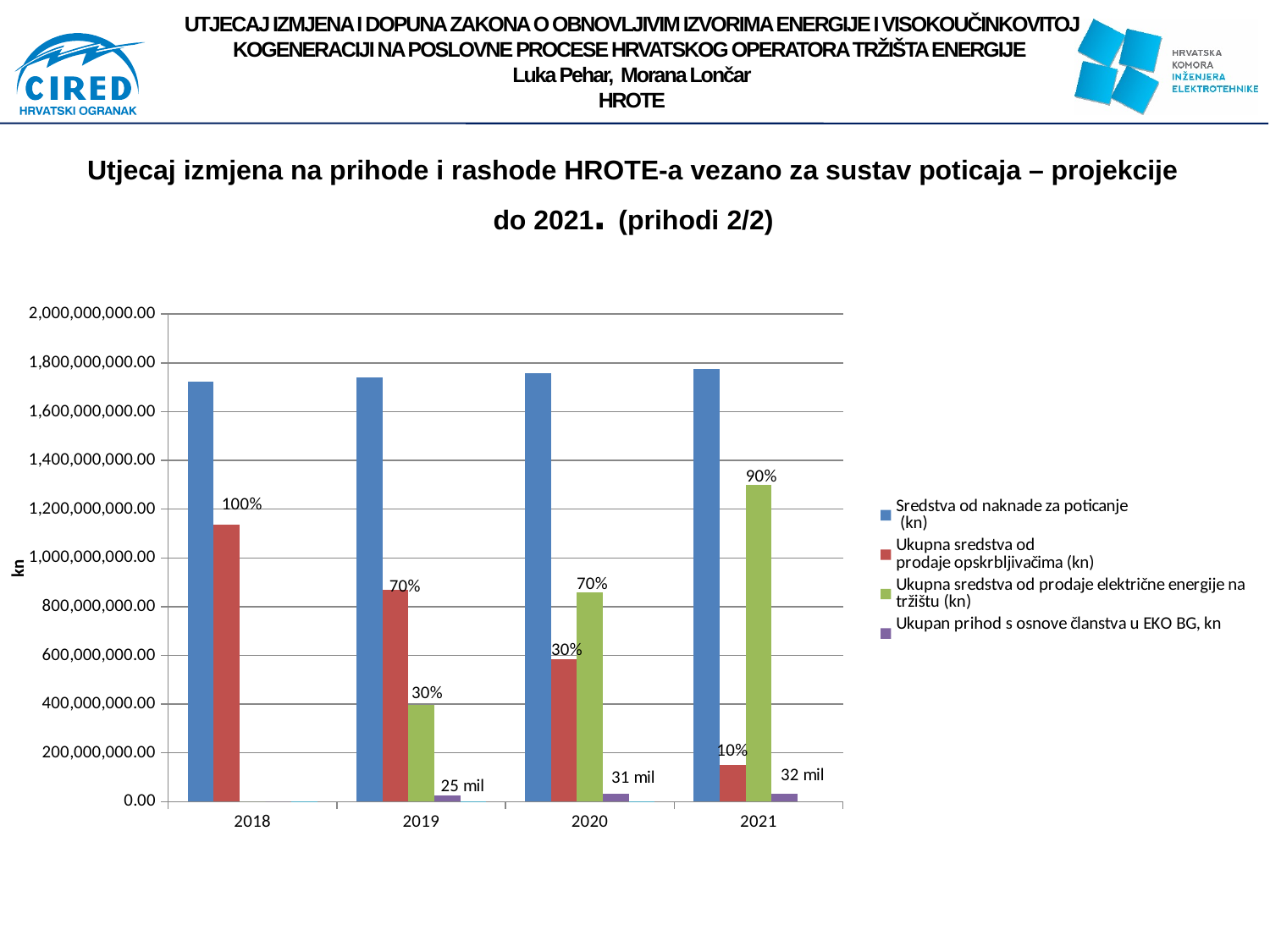
What data label is shown on the 'Ukupna sredstva od prodaje električne energije na tržištu (kn)' bar for 2021? 90% What is the label on the vertical axis of the chart? kn Is the value for 'Ukupna sredstva od prodaje električne energije na tržištu (kn)' in 2019 greater or less than 600,000,000.00? less How many years are shown on the x axis of the chart? 4 What data label is shown on the 'Ukupna sredstva od prodaje opskrbljivačima (kn)' bar for 2018? 100% How many series does the chart legend list? 4 In 2021, which is larger: 'Ukupna sredstva od prodaje opskrbljivačima (kn)' or 'Ukupna sredstva od prodaje električne energije na tržištu (kn)'? Ukupna sredstva od prodaje električne energije na tržištu (kn) What data label is shown on the 'Ukupan prihod s osnove članstva u EKO BG, kn' bar for 2019? 25 mil In which year is the 'Ukupna sredstva od prodaje opskrbljivačima (kn)' bar lowest? 2021 What kind of chart is shown on the slide? bar chart What data label is shown on the 'Ukupan prihod s osnove članstva u EKO BG, kn' bar for 2021? 32 mil Is the value for 'Sredstva od naknade za poticanje (kn)' in 2018 greater or less than 1,600,000,000.00? greater